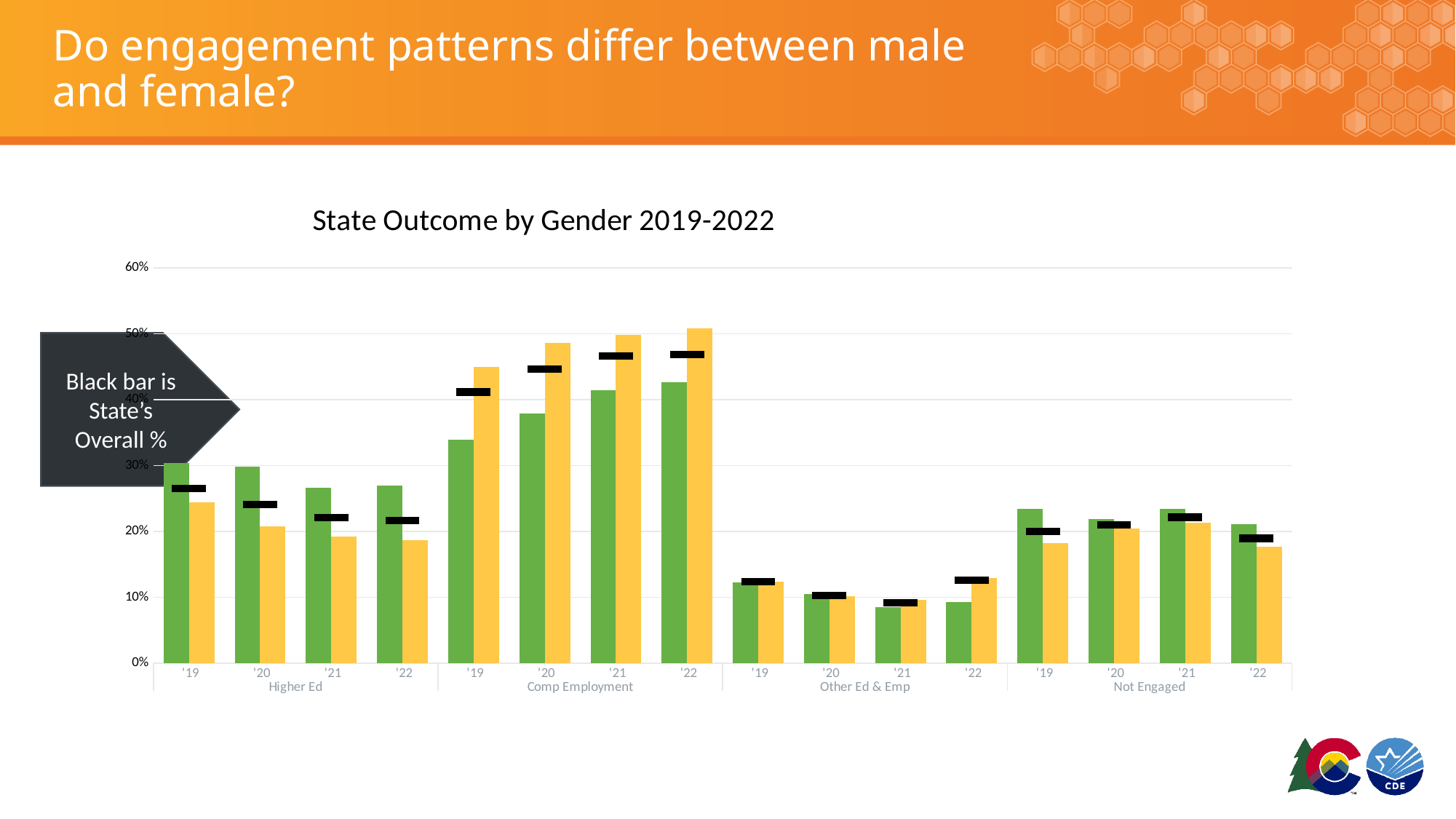
Is the yellow bar for Higher Ed '22 greater or less than 20%? less Do the yellow bars in the Comp Employment group rise or fall from '19 to '22? rise How many outcome groups are shown along the x axis of the chart? 4 How many years are shown within each outcome group on the chart? 4 Which outcome group and year has the tallest bar on the chart? Comp Employment '22 In Comp Employment '22, which bar is taller, the green bar or the yellow bar? the yellow bar According to the callout, what does the black bar on the chart represent? State's Overall % Which outcome group and year has the shortest bar on the chart? Other Ed & Emp '21 Is the green bar for Other Ed & Emp '21 greater or less than 10%? less What is the title of the chart? State Outcome by Gender 2019-2022 Is the green bar for Comp Employment '19 greater or less than 30%? greater What kind of chart is shown on the slide? bar chart